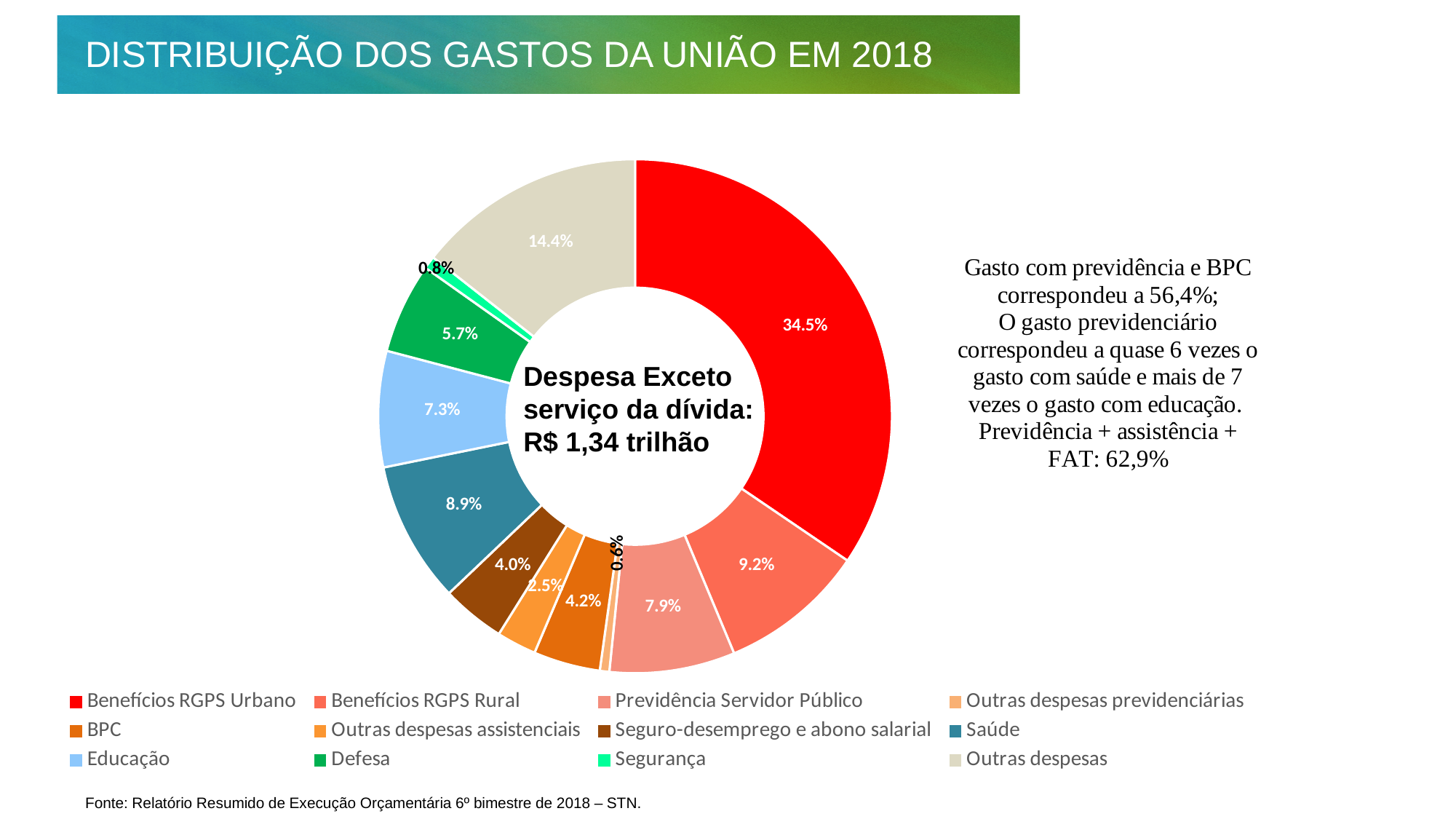
What is the difference between the shares of Benefícios RGPS Urbano and Benefícios RGPS Rural? 25.3% What is the value for Outras despesas in the chart? 14.4% What type of chart is shown on the slide? Doughnut chart Which category has the smallest share in the chart? Outras despesas previdenciárias What share of the doughnut chart does Benefícios RGPS Urbano represent? 34.5% How many categories does the chart's legend list? 12 What percentage is labelled for Educação? 7.3% What text appears in the centre of the doughnut chart? Despesa Exceto serviço da dívida: R$ 1,34 trilhão Which category has the largest share in the chart? Benefícios RGPS Urbano What is the combined share of Defesa and Segurança? 6.5% What is the value shown for Saúde in the chart? 8.9% Which is larger, the share for Saúde or the share for Educação? Saúde